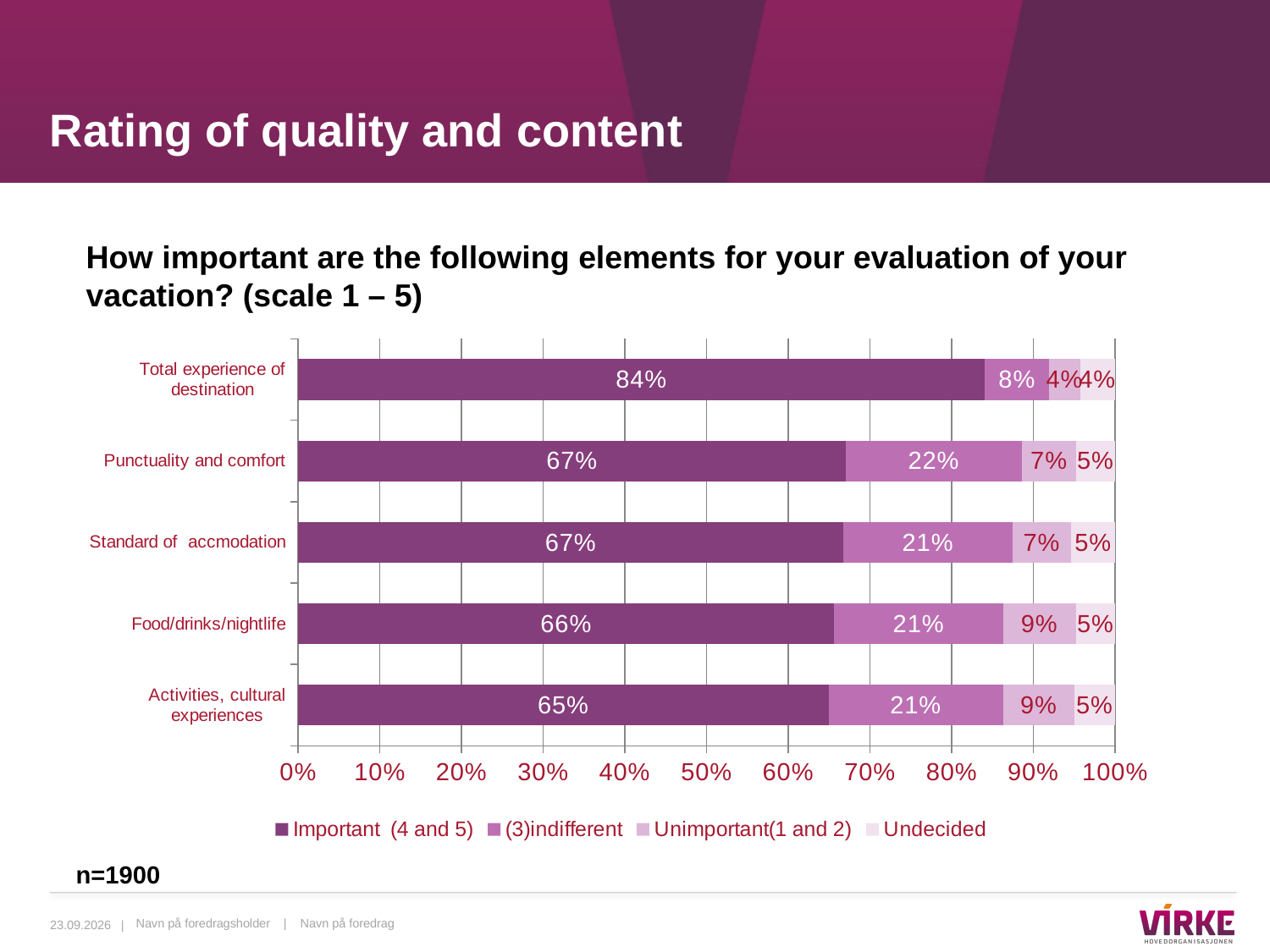
Which category has the highest Important (4 and 5) value? Total experience of destination What is the Unimportant(1 and 2) value for 'Food/drinks/nightlife'? 9% How many categories are shown on the chart? 5 Which has a larger Unimportant(1 and 2) value: 'Food/drinks/nightlife' or 'Standard of accmodation'? Food/drinks/nightlife What percentage rated 'Total experience of destination' as Important (4 and 5)? 84% What kind of chart is shown on the slide? Stacked bar chart What is the difference between the Important (4 and 5) values for 'Total experience of destination' and 'Punctuality and comfort'? 17 percentage points Which category has the lowest Important (4 and 5) value? Activities, cultural experiences What is the total of the stacked bar for 'Total experience of destination'? 100% How many series does the legend list? 4 What is the (3)indifferent value for 'Punctuality and comfort'? 22% What sample size is stated below the chart? n=1900